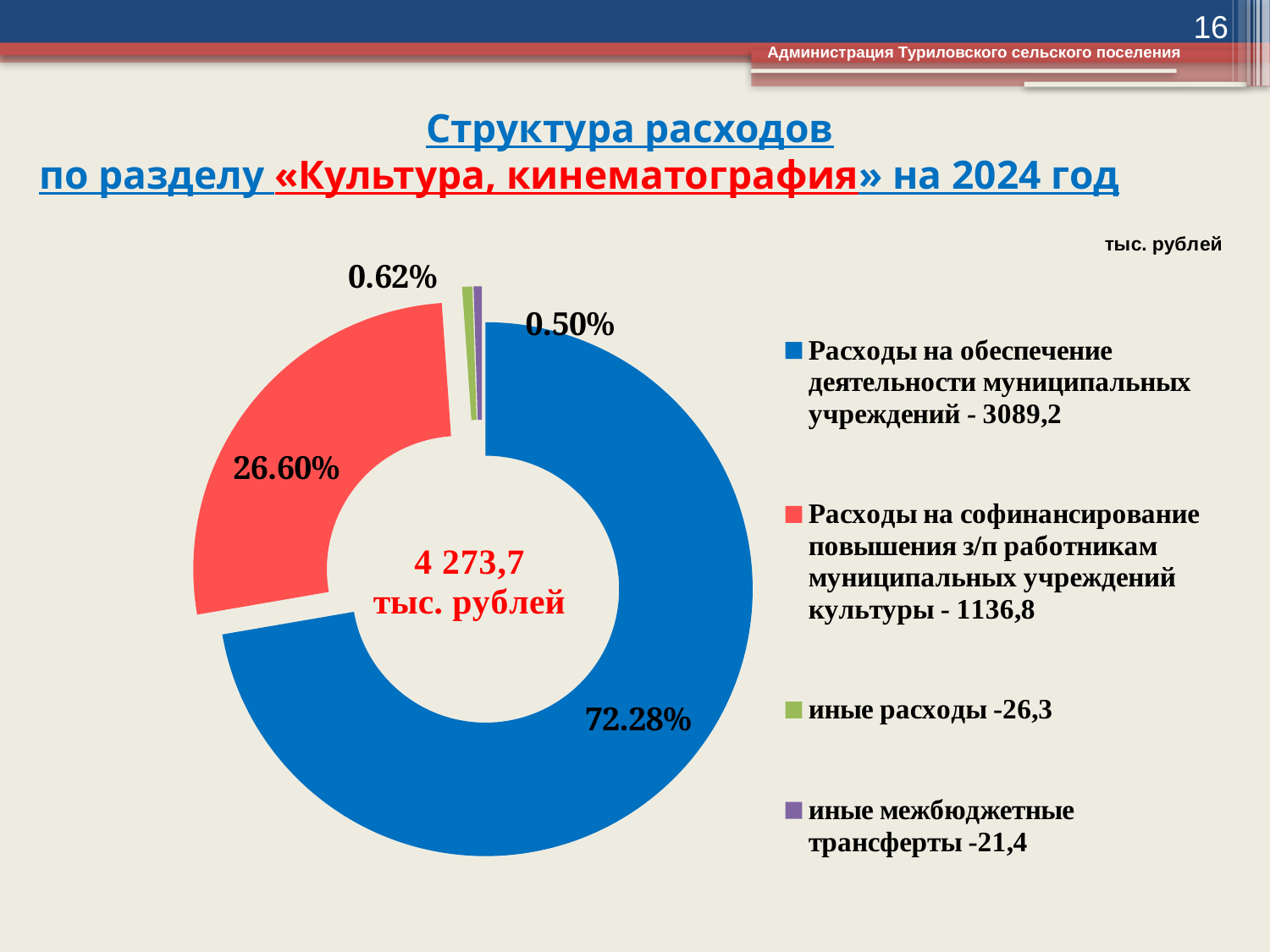
What share of the chart does «иные расходы» take? 0.62% What kind of chart is shown on the slide? Doughnut (pie) chart What is the value (тыс. рублей) for «иные межбюджетные трансферты» according to the legend? 21,4 What is the total amount shown in the centre of the chart? 4 273,7 тыс. рублей What share of the chart does «Расходы на софинансирование повышения з/п работникам муниципальных учреждений культуры» take? 26.60% Which category has the largest share of the chart? Расходы на обеспечение деятельности муниципальных учреждений What is the value (тыс. рублей) for «Расходы на обеспечение деятельности муниципальных учреждений» according to the legend? 3089,2 What share of the chart does «Расходы на обеспечение деятельности муниципальных учреждений» take? 72.28% What is the difference in percentage points between the 72.28% slice and the 26.60% slice? 45.68% Which category has the smallest share of the chart? иные межбюджетные трансферты How many categories does the legend list? 4